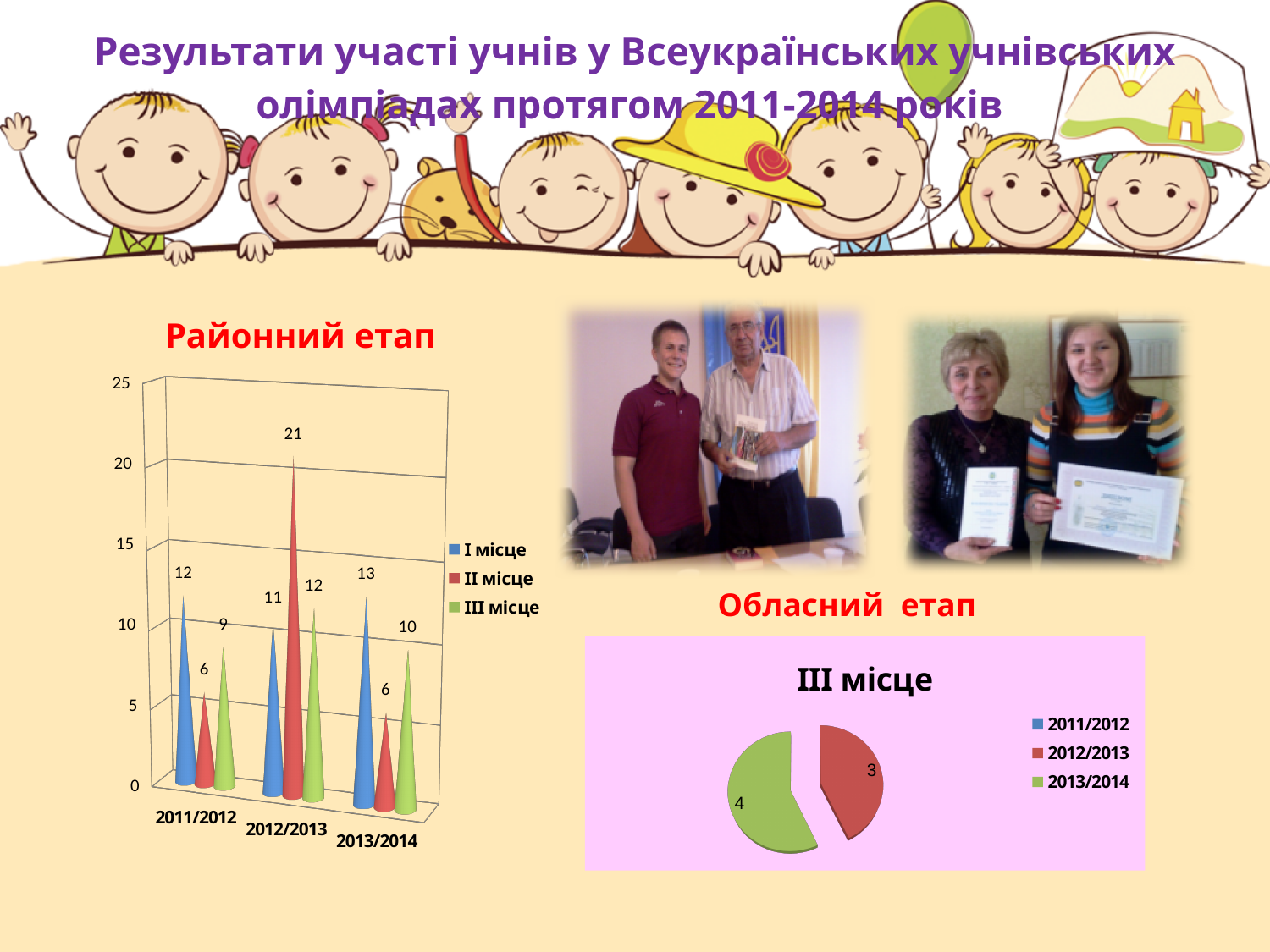
In the 'Районний етап' chart, which year has the highest value for II місце? 2012/2013 In the 'Районний етап' chart, which is larger: III місце in 2012/2013 or III місце in 2013/2014? III місце in 2012/2013 In the 'Районний етап' chart, what is the difference between II місце and I місце in 2012/2013? 10 How many year categories are shown on the x axis of the 'Районний етап' chart? 3 In the 'Районний етап' chart, what is the value for I місце in 2013/2014? 13 In the 'Районний етап' chart, what is the value for II місце in 2012/2013? 21 What kind of chart is the 'III місце' chart under 'Обласний етап'? pie chart In the 'III місце' pie chart, which is larger: 2012/2013 or 2013/2014? 2013/2014 In the 'III місце' pie chart, what is the value for 2013/2014? 4 In the 'Районний етап' chart, what is the value for III місце in 2011/2012? 9 In the 'Районний етап' chart, which series has the lowest value in 2011/2012? II місце How many series does the legend of the 'Районний етап' chart list? 3